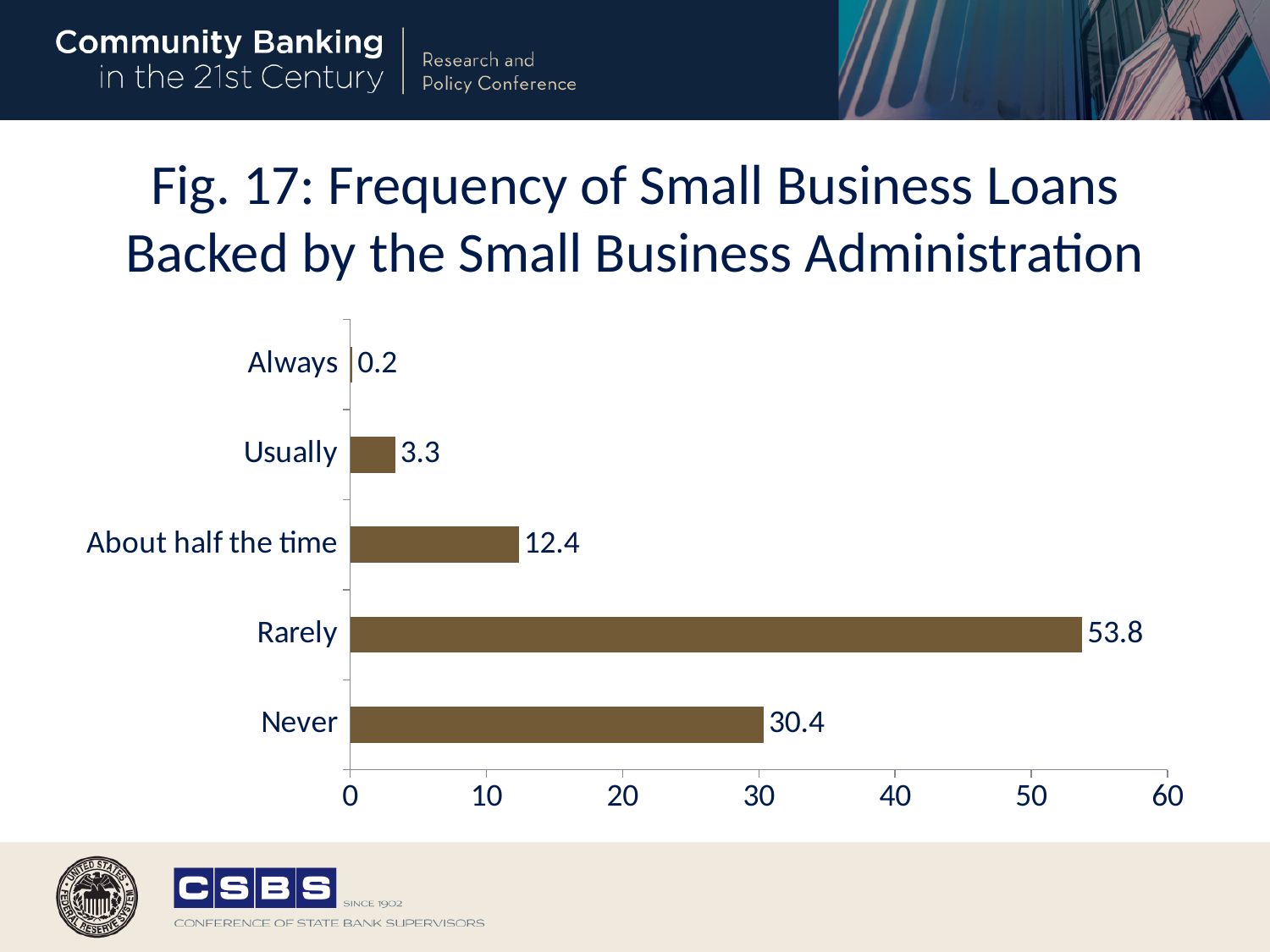
What is the difference between the values for Rarely and Never? 23.4 How many categories are shown in the chart? 5 What is the value for Rarely? 53.8 Is the value for Rarely greater or less than 50? greater What is the value for Never? 30.4 What is the value for Usually? 3.3 Which category has the highest value? Rarely Which is larger, the value for Never or the value for About half the time? Never What is the value for Always? 0.2 What kind of chart is shown on the slide? Bar chart Which category has the lowest value? Always What is the value for About half the time? 12.4